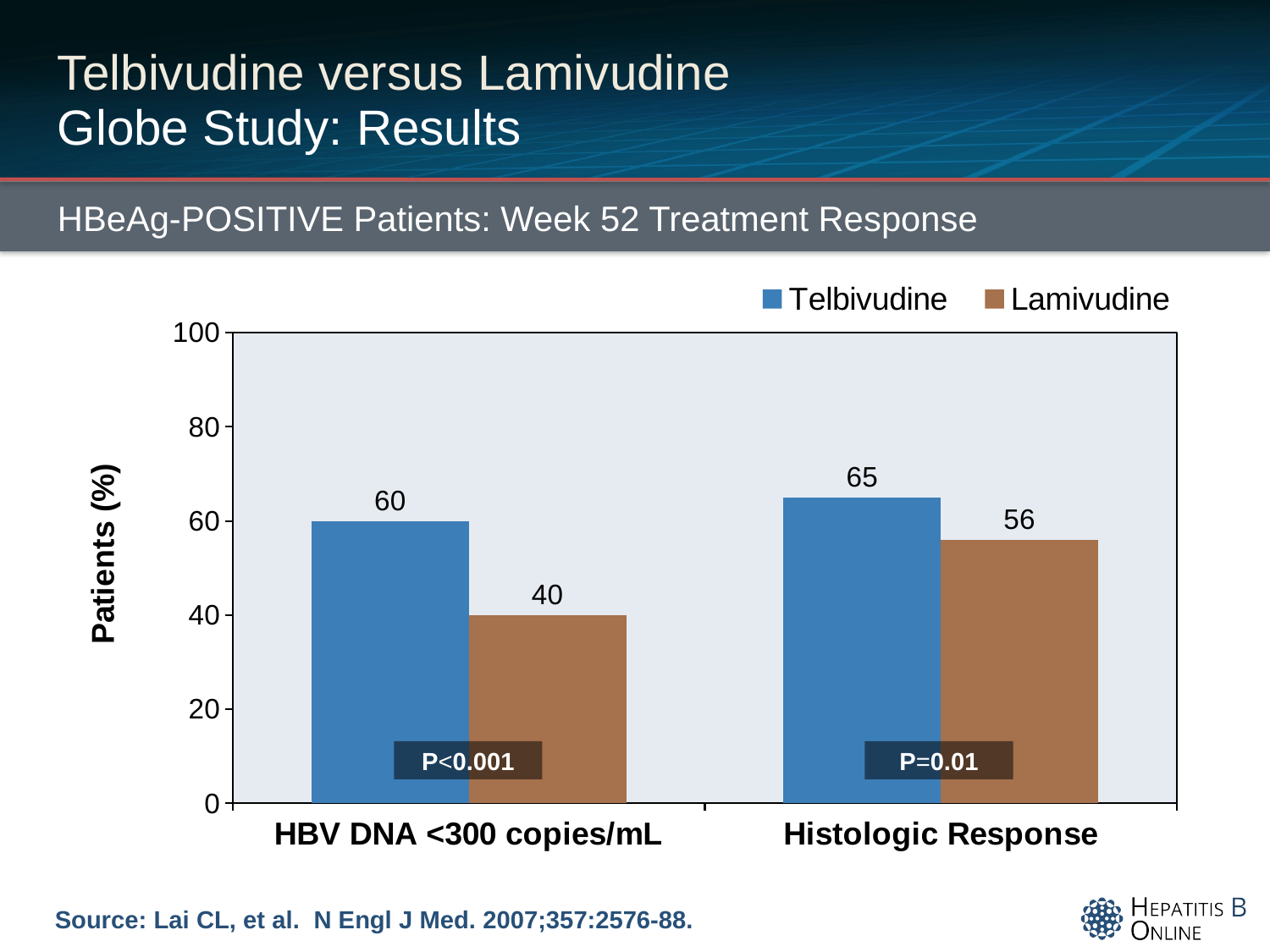
What percentage of Lamivudine patients achieved HBV DNA <300 copies/mL? 40 What is the label of the y axis? Patients (%) What percentage of Telbivudine patients had a Histologic Response? 65 Which bar in the chart has the highest value? Telbivudine, Histologic Response What kind of chart is shown on the slide? Bar chart What is the difference between Telbivudine and Lamivudine for Histologic Response? 9 How many series does the legend list? 2 Which bar in the chart has the lowest value? Lamivudine, HBV DNA <300 copies/mL What percentage of Lamivudine patients had a Histologic Response? 56 What is the difference between Telbivudine and Lamivudine for HBV DNA <300 copies/mL? 20 Which treatment had the higher Histologic Response rate, Telbivudine or Lamivudine? Telbivudine What percentage of Telbivudine patients achieved HBV DNA <300 copies/mL? 60